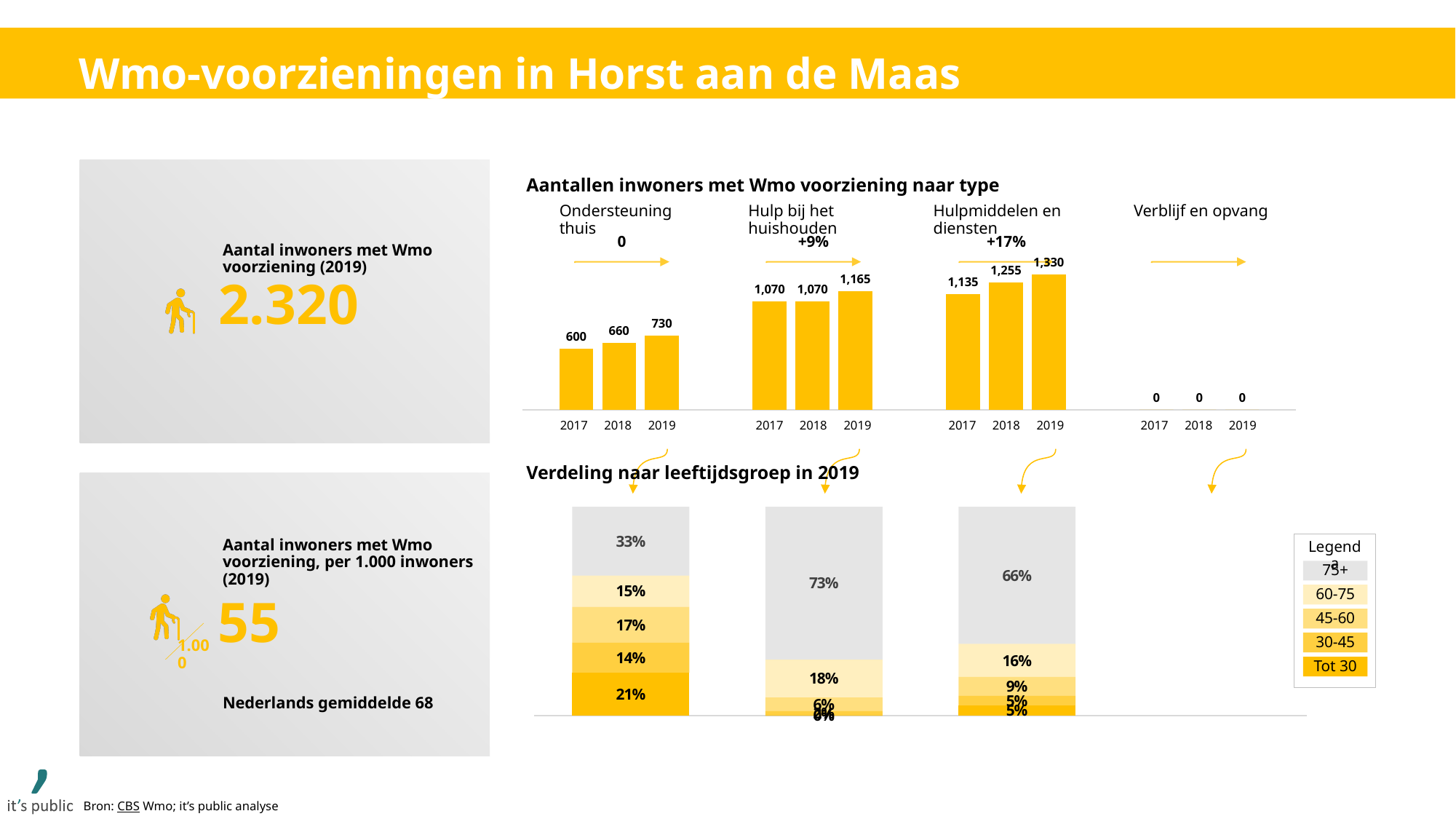
In the chart 'Aantallen inwoners met Wmo voorziening naar type', what percentage change is shown above Hulpmiddelen en diensten? +17% In the chart 'Aantallen inwoners met Wmo voorziening naar type', what is the value for Hulp bij het huishouden in 2017? 1,070 In the chart 'Aantallen inwoners met Wmo voorziening naar type', do the values for Hulpmiddelen en diensten rise or fall from 2017 to 2019? rise In the chart 'Aantallen inwoners met Wmo voorziening naar type', which type has the highest value in 2019? Hulpmiddelen en diensten What kind of chart is 'Aantallen inwoners met Wmo voorziening naar type'? bar chart In the chart 'Aantallen inwoners met Wmo voorziening naar type', which type has the lowest value in 2019? Verblijf en opvang In the chart 'Aantallen inwoners met Wmo voorziening naar type', what is the value for Hulpmiddelen en diensten in 2018? 1,255 In the chart 'Aantallen inwoners met Wmo voorziening naar type', what is the value for Ondersteuning thuis in 2019? 730 In the chart 'Aantallen inwoners met Wmo voorziening naar type', what is the difference between the 2019 and 2017 values for Ondersteuning thuis? 130 In the chart 'Verdeling naar leeftijdsgroep in 2019', what is the share of the 75+ group for Ondersteuning thuis? 33% How many age groups does the legend of 'Verdeling naar leeftijdsgroep in 2019' list? 5 In the chart 'Verdeling naar leeftijdsgroep in 2019', what is the share of the Tot 30 group for Ondersteuning thuis? 21%